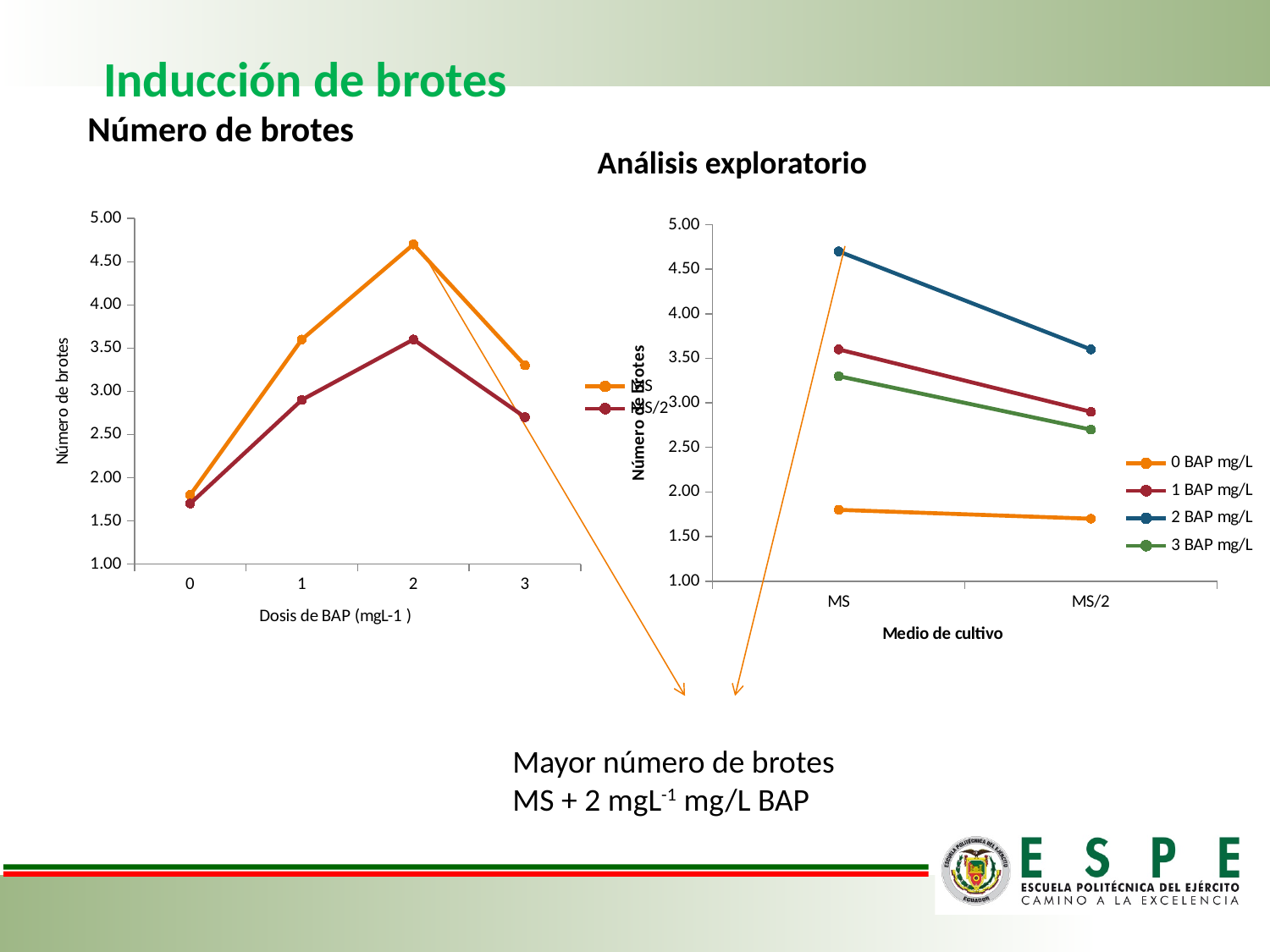
How many series does the legend of the left chart list? 2 How many series does the legend of the right chart (Análisis exploratorio) list? 4 In the right chart, does the 2 BAP mg/L series rise or fall from MS to MS/2? fall In the left chart, at which BAP dose does the MS series reach its highest value? 2 In the right chart, which series has the lowest value at the MS/2 medium? 0 BAP mg/L What kind of chart is the left chart (Número de brotes vs Dosis de BAP)? line chart In the left chart, is the MS/2 value at dose 0 greater or less than 2.00? less In the right chart, which series has the highest value at the MS medium? 2 BAP mg/L How many BAP dose levels are plotted on the x axis of the left chart? 4 In the right chart, which is larger at the MS medium: 1 BAP mg/L or 3 BAP mg/L? 1 BAP mg/L In the left chart, is the MS value at dose 2 greater or less than 4.50? greater What is the x-axis title of the right chart? Medio de cultivo